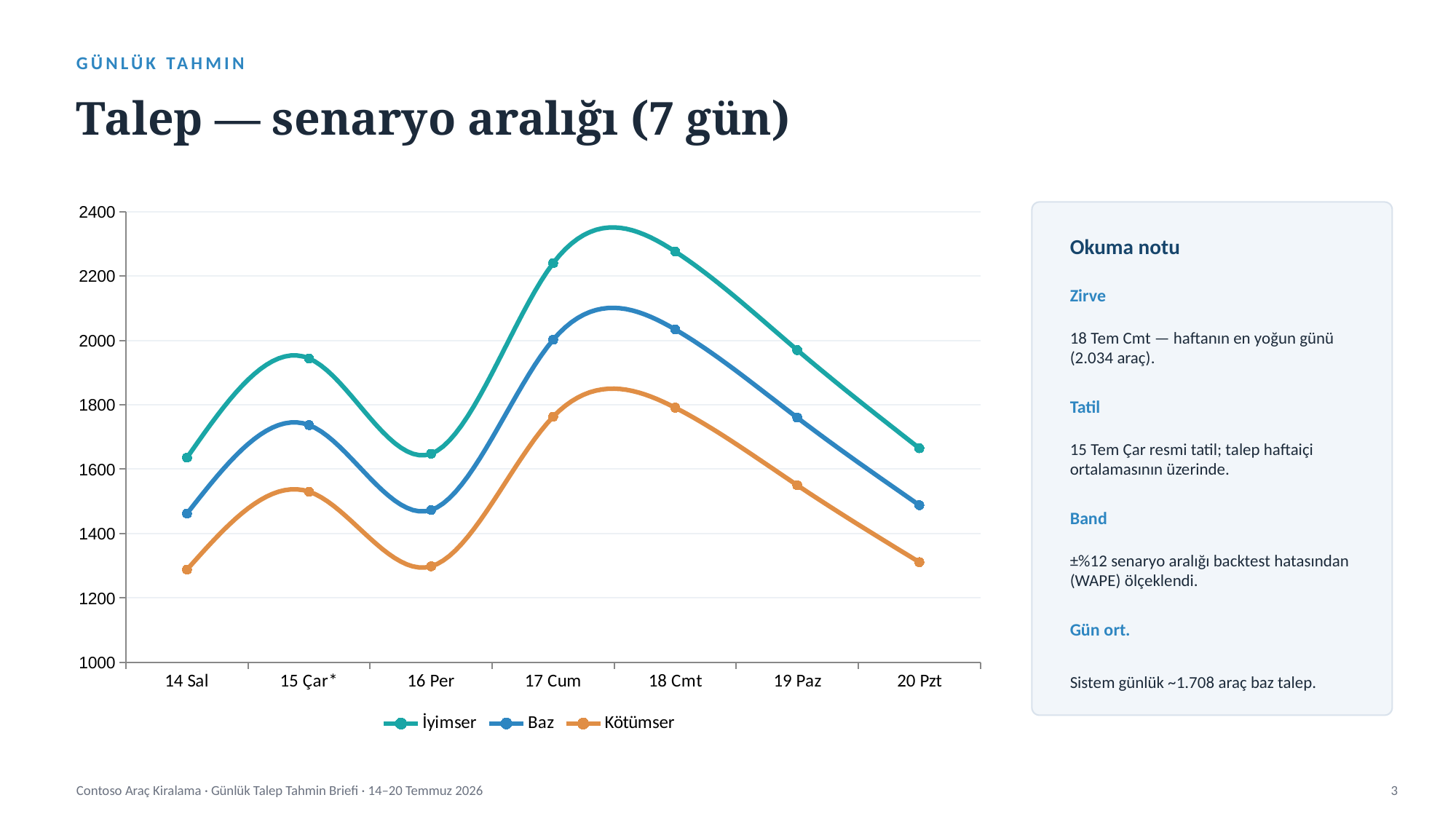
On which day does the Baz series reach its highest value? 18 Cmt What kind of chart is shown on the slide? line chart Is the Kötümser value for 16 Per greater or less than 1200? greater How many series does the chart legend list? 3 What are the three series names listed in the legend? İyimser, Baz, Kötümser On which day does the İyimser series reach its highest value? 18 Cmt Is the Baz value for 20 Pzt greater or less than 1600? less Is the İyimser value for 18 Cmt greater or less than 2200? greater Do the values of all three series rise or fall from 18 Cmt to 20 Pzt? fall Which is larger for the Baz series: the value on 17 Cum or the value on 19 Paz? 17 Cum How many days (categories) are plotted on the x axis? 7